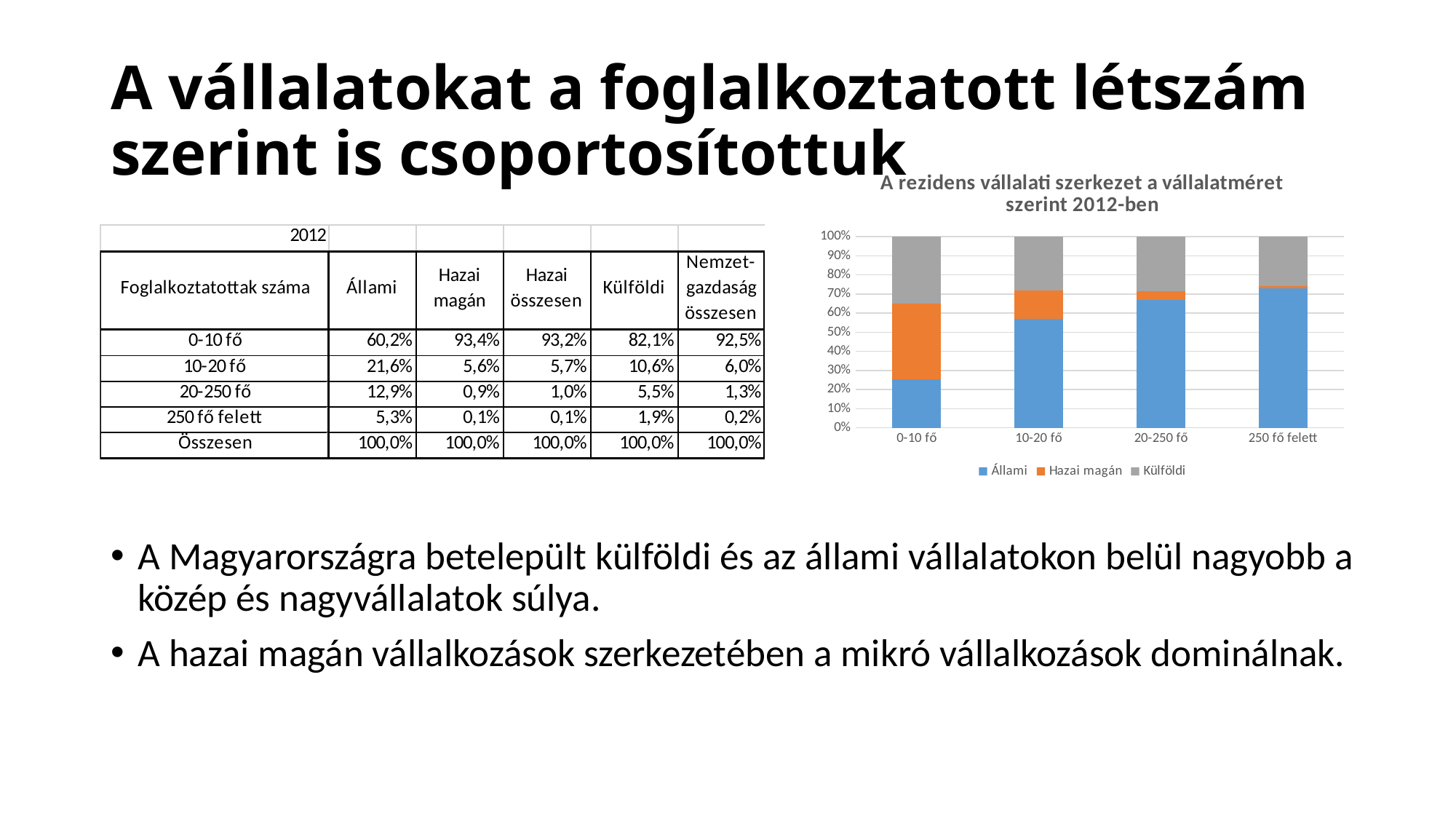
Is the Állami share for the 250 fő felett category greater or less than 60%? greater What kind of chart is shown on the slide? Stacked bar chart How many series does the chart's legend list? 3 Which colour represents the Állami series in the chart? Blue How many company-size categories are shown on the x axis of the chart? 4 Which category has the largest Állami share in the chart? 250 fő felett Which category has the largest Hazai magán share in the chart? 0-10 fő Is the Állami share for the 20-250 fő category greater or less than 60%? greater Does the Állami share rise or fall as company size increases along the x axis? Rises Is the Állami share for the 10-20 fő category greater or less than 50%? greater What is the title of the chart? A rezidens vállalati szerkezet a vállalatméret szerint 2012-ben